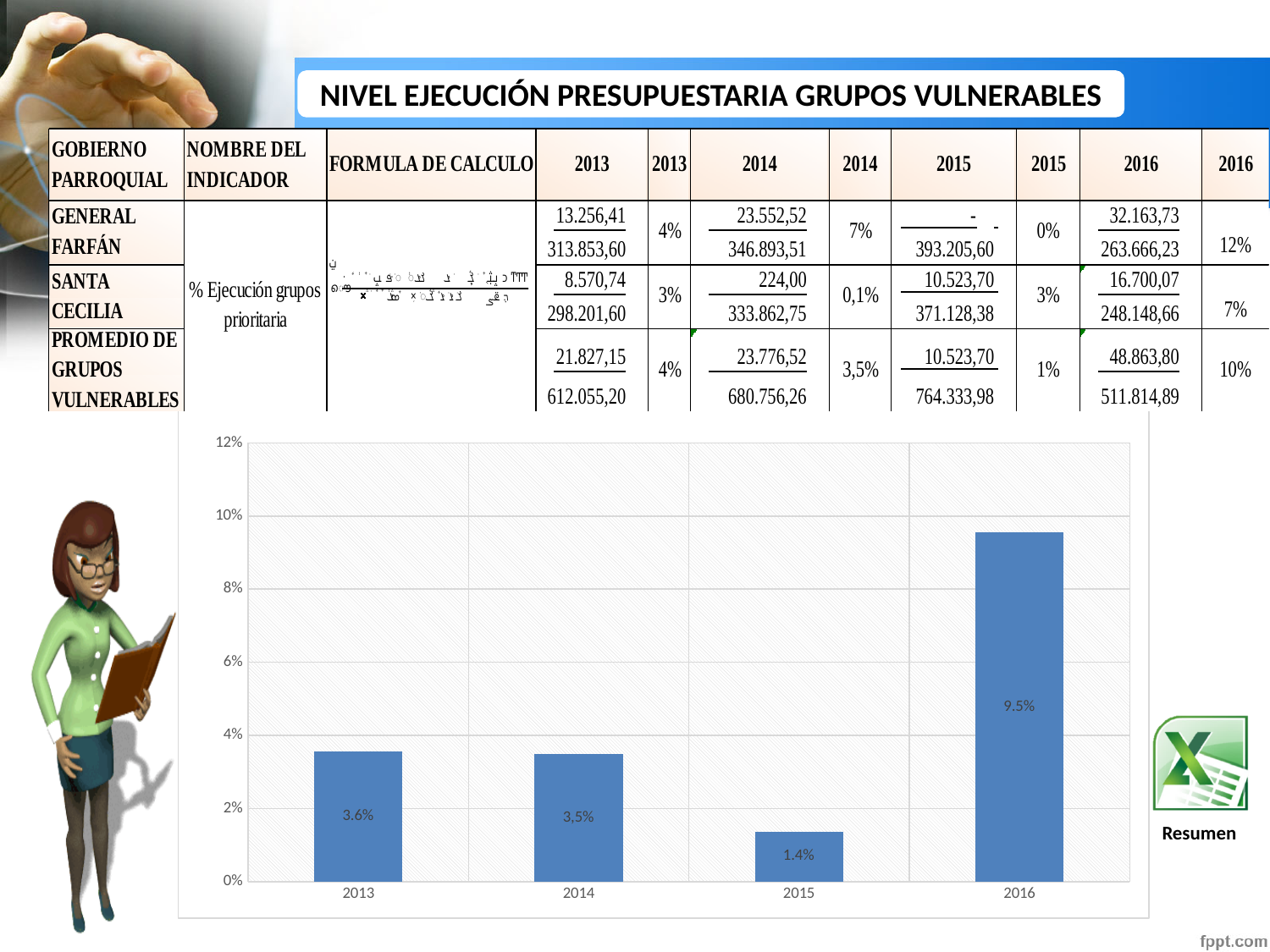
Which is larger in the bar chart, the value for 2016 or the value for 2013? 2016 What is the value shown for 2014 in the bar chart? 3,5% What is the value shown for 2016 in the bar chart? 9.5% Which year has the lowest value in the bar chart? 2015 What is the difference between the values for 2016 and 2015 in the bar chart? 8.1% What type of chart is shown on the slide? bar chart Is the value for 2016 in the bar chart greater or less than 8%? greater What is the value shown for 2015 in the bar chart? 1.4% Which year has the highest value in the bar chart? 2016 Does the value rise or fall from 2015 to 2016 in the bar chart? rise What is the value shown for 2013 in the bar chart? 3.6% How many years are shown on the x axis of the bar chart? 4